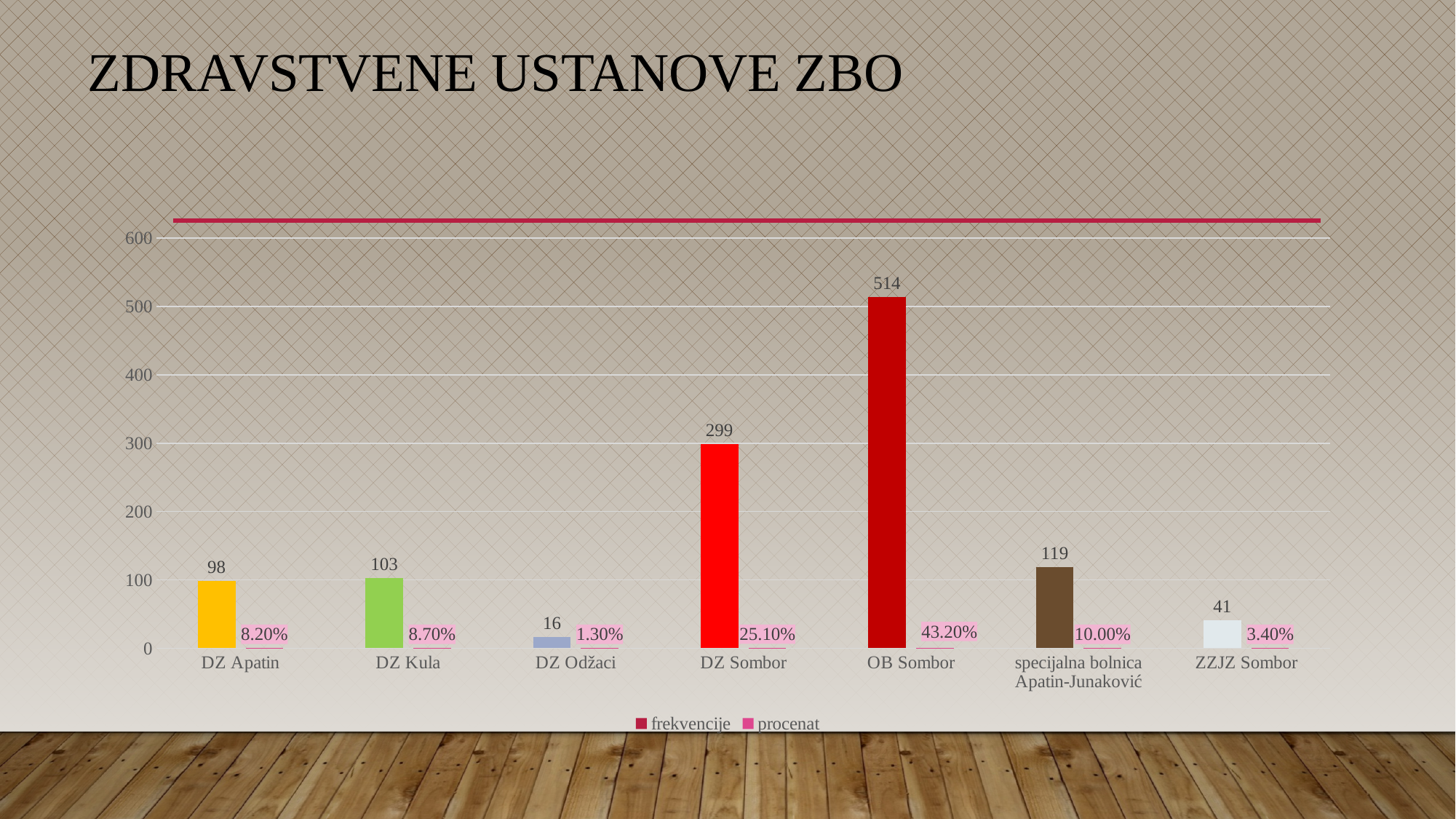
How many categories are shown on the x axis? 7 What is the difference between the frekvencije values for OB Sombor and DZ Sombor? 215 How many series does the legend list? 2 What is the frekvencije value for OB Sombor? 514 What is the procenat value for DZ Sombor? 25.10% Which category has the highest frekvencije value? OB Sombor Which has a larger frekvencije value, DZ Kula or DZ Apatin? DZ Kula What kind of chart is shown on the slide? bar chart What is the frekvencije value for specijalna bolnica Apatin-Junaković? 119 Is the frekvencije value for DZ Sombor greater or less than 200? greater Which category has the lowest frekvencije value? DZ Odžaci What is the procenat value for ZZJZ Sombor? 3.40%